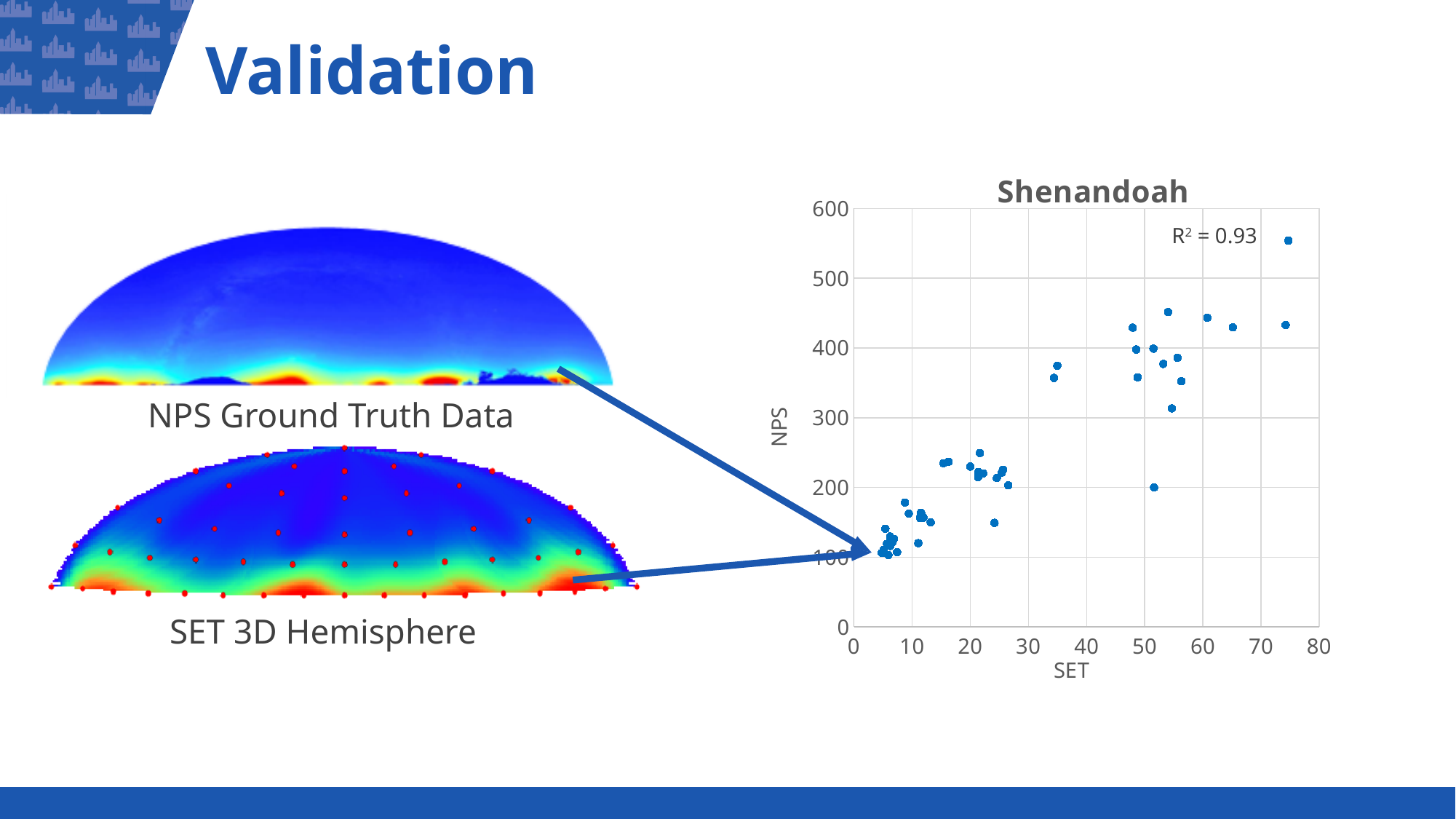
In the Shenandoah chart, are the NPS values of the points with SET below 10 greater or less than 200? less In the Shenandoah chart, which has the higher NPS: the point at about SET = 75 with the highest NPS, or the points near SET = 35? the point at about SET = 75 In the Shenandoah chart, is the largest SET value plotted greater or less than 70? greater In the Shenandoah chart, is the maximum value shown on the NPS axis greater or less than 500? greater What R² value is printed on the Shenandoah chart? R² = 0.93 In the Shenandoah chart, do NPS values generally rise or fall as SET increases? rise What is the label of the x axis of the Shenandoah chart? SET What kind of chart is shown on the slide? scatter chart What is the title of the chart on the slide? Shenandoah